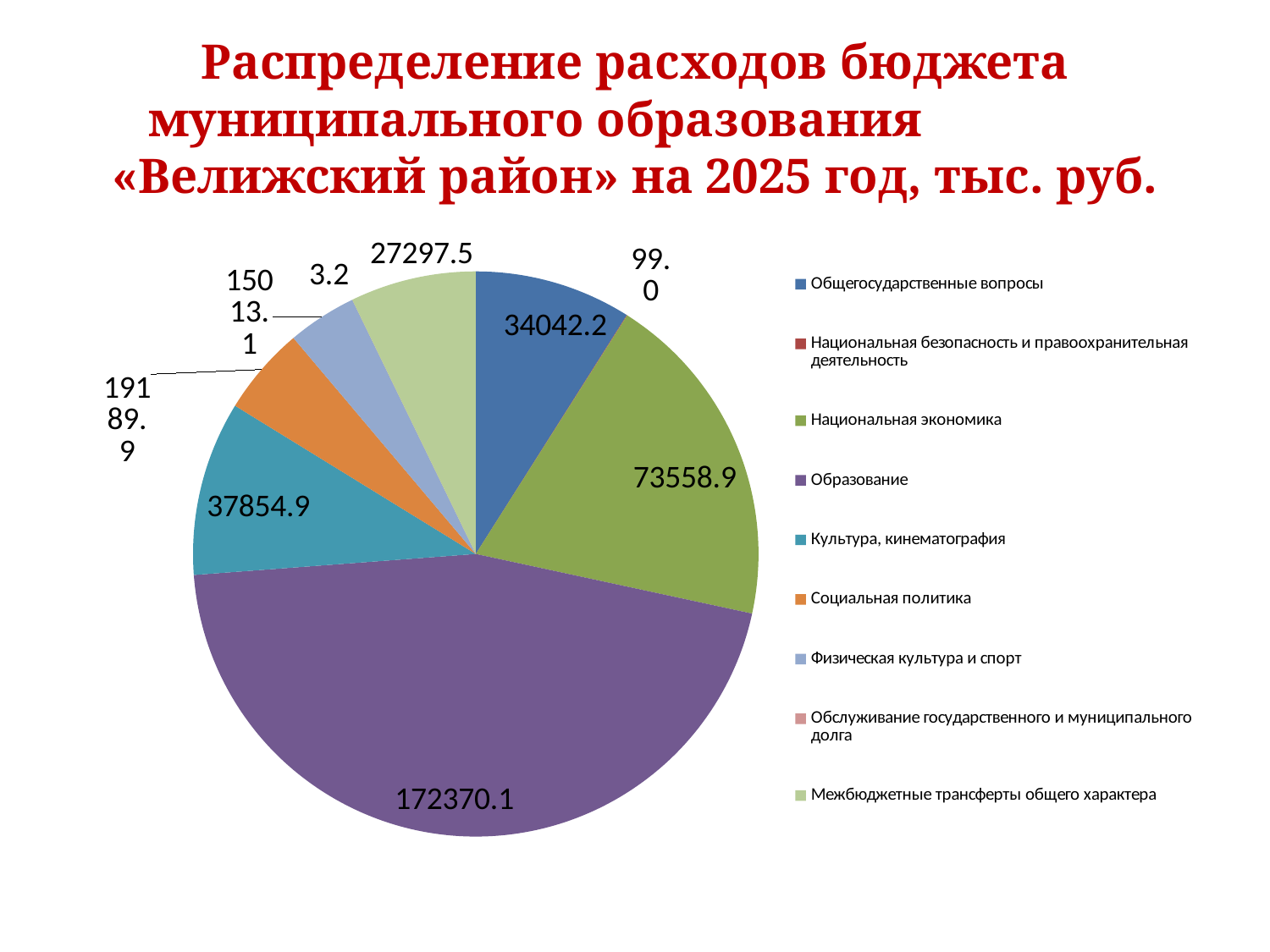
What is the difference between the values for Образование and Национальная экономика? 98811.2 Which is larger, the value for Культура, кинематография or the value for Общегосударственные вопросы? Культура, кинематография How many categories does the legend of the pie chart list? 9 What is the value shown for Межбюджетные трансферты общего характера? 27297.5 What kind of chart is shown on the slide? pie chart Which category has the smallest slice of the pie chart? Обслуживание государственного и муниципального долга What is the value shown for Общегосударственные вопросы? 34042.2 Which category has the largest slice of the pie chart? Образование What is the value shown for Национальная экономика? 73558.9 What colour is the slice for Образование? purple What is the value shown for Образование? 172370.1 What is the value shown for Культура, кинематография? 37854.9